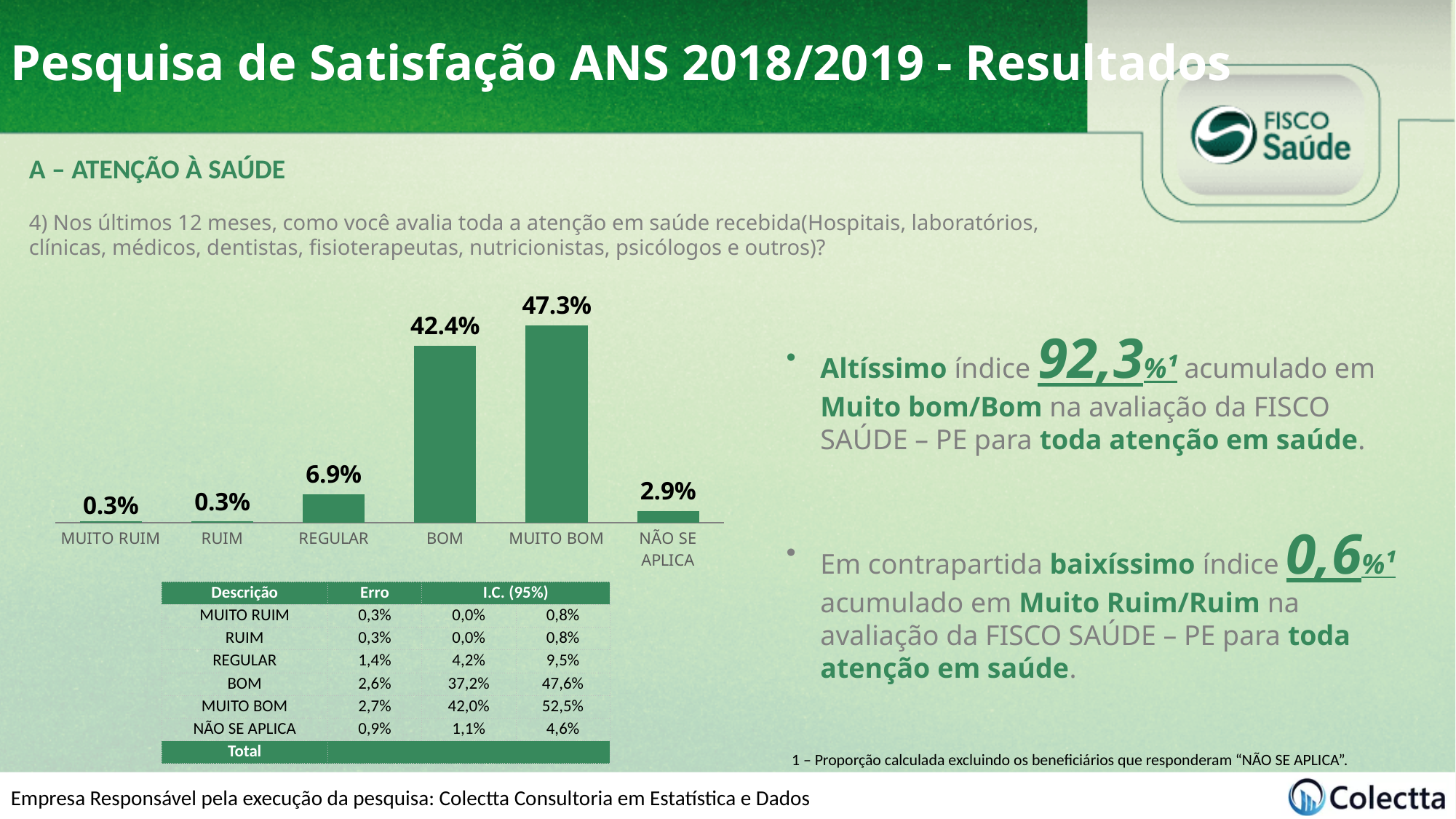
What is the difference between the values for MUITO BOM and BOM? 4.9% What is the difference between the values for REGULAR and NÃO SE APLICA? 4.0% How many categories are shown in the bar chart? 6 What is the value for MUITO BOM? 47.3% What is the value for BOM? 42.4% What is the value for NÃO SE APLICA? 2.9% What is the value for MUITO RUIM? 0.3% What is the value for REGULAR? 6.9% Which category has the highest value? MUITO BOM What kind of chart is shown on the slide? bar chart Which is larger, the value for REGULAR or the value for NÃO SE APLICA? REGULAR What colour are the bars in the chart? green